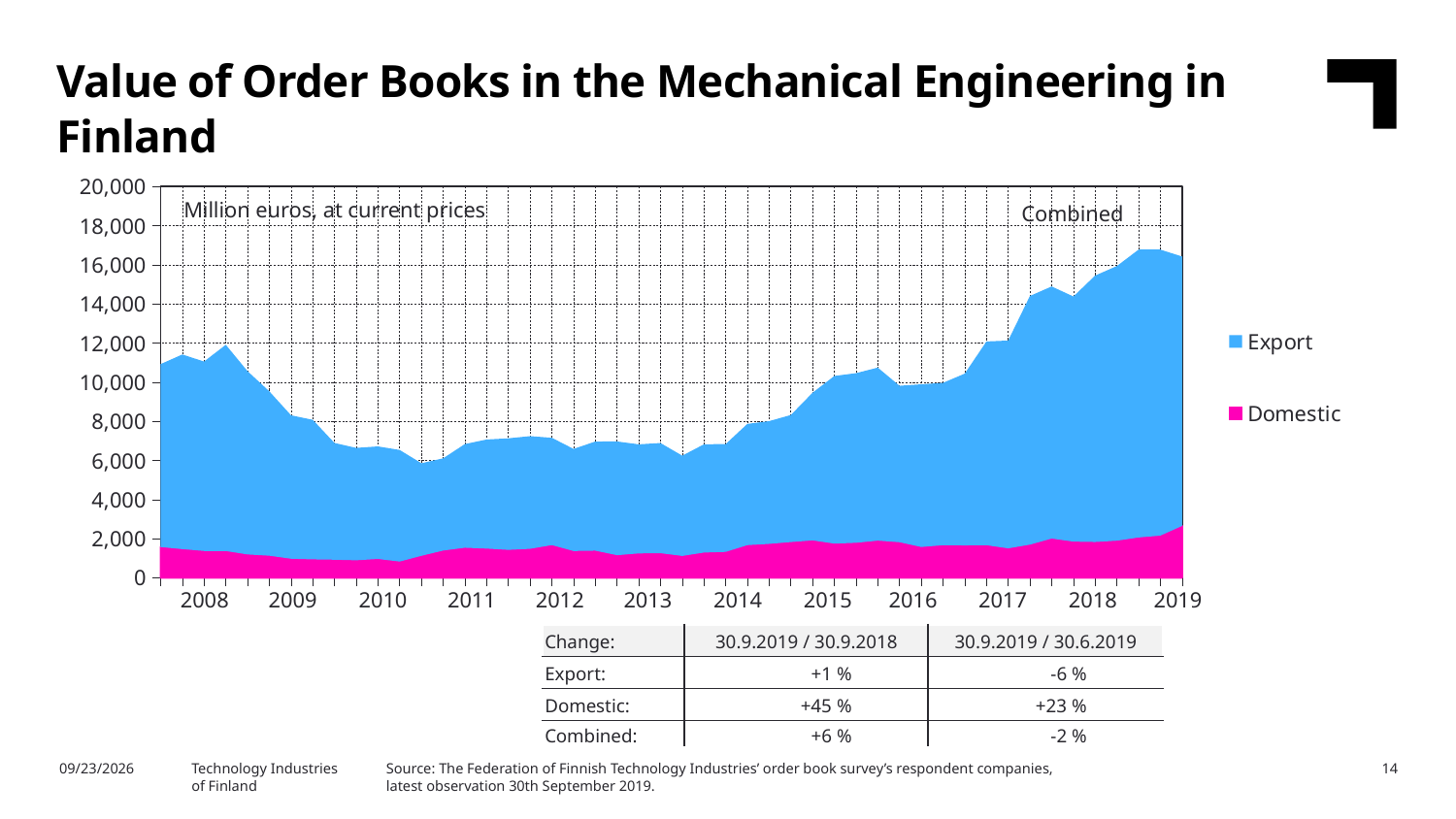
Is the Domestic value in 2010 greater or less than 2,000? less How many series does the chart legend list? 2 Is the combined value of order books at the end of 2019 greater or less than 14,000? greater Does the combined value of order books rise or fall between 2016 and 2019? rise Is the combined value of order books higher in 2019 or in 2008? 2019 Which two series are listed in the chart legend? Export and Domestic What kind of chart is shown on the slide? Stacked area chart Is the combined value of order books in 2011 greater or less than 8,000? less Does the combined value of order books rise or fall between 2008 and 2010? fall In what unit are the values on the chart expressed, according to the note inside the plot area? Million euros, at current prices